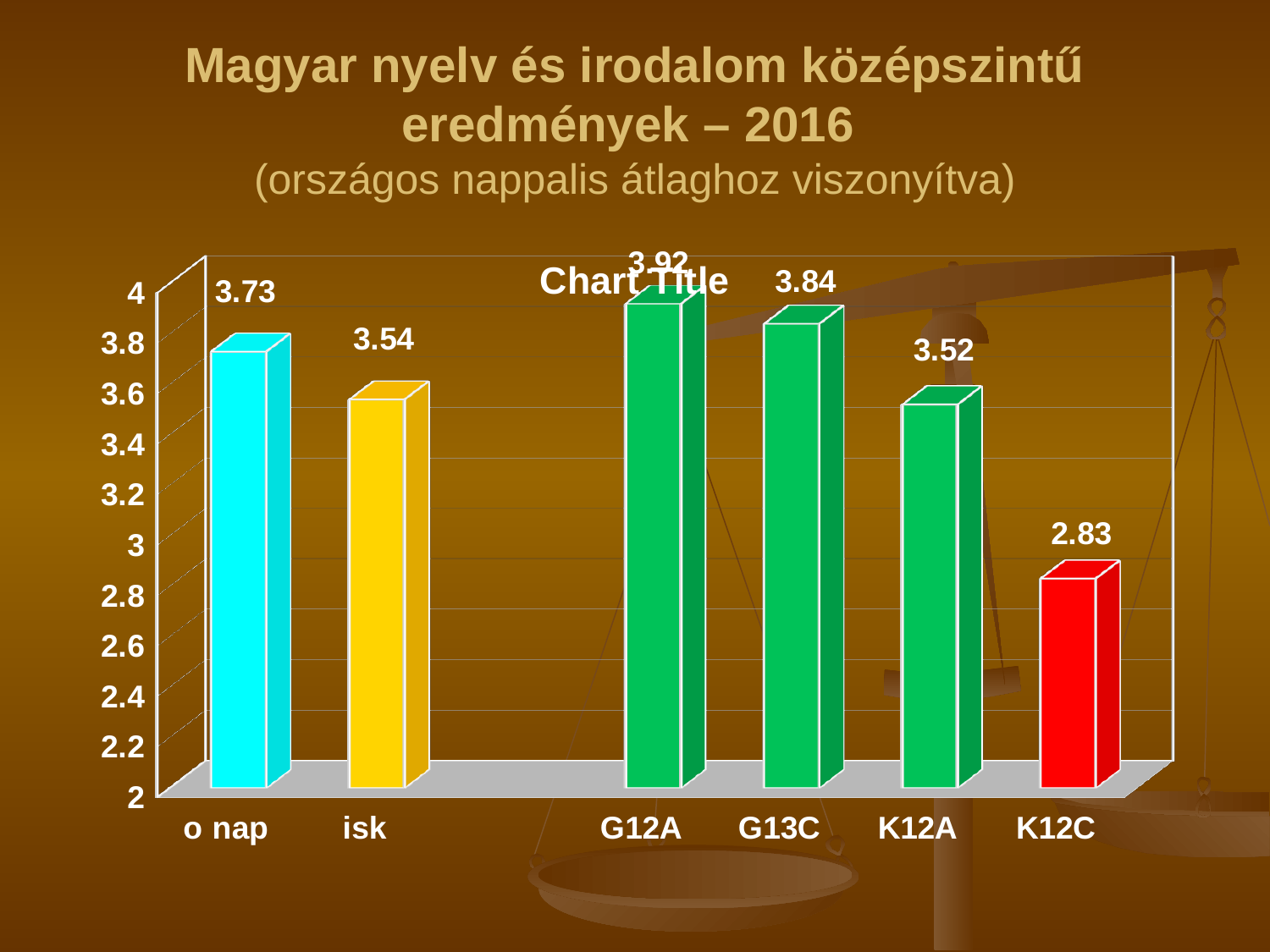
How many labelled categories are shown on the x axis? 6 Which category has the lowest value? K12C Which is larger, the value for G13C or the value for K12A? G13C What is the difference between the values for G12A and K12C? 1.09 What is the value for o nap? 3.73 What is the value for G12A? 3.92 What kind of chart is shown on the slide? bar chart What is the value for K12C? 2.83 What is the difference between the values for o nap and isk? 0.19 Is the value for K12C greater or less than 3? less Which category has the highest value? G12A What is the value for isk? 3.54